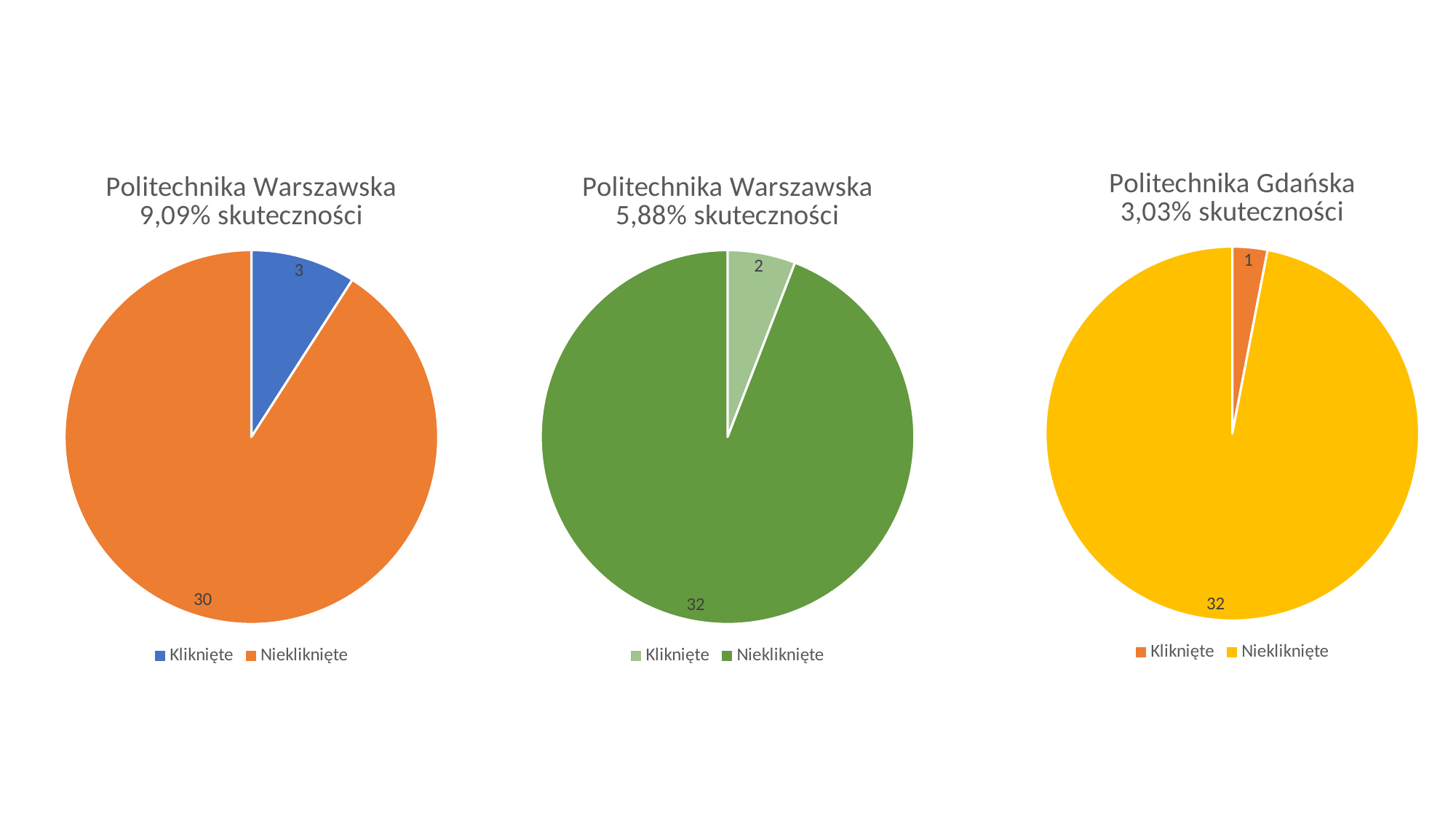
How many entries does the legend of the middle chart (Politechnika Warszawska 5,88% skuteczności) list? 2 In the right chart (Politechnika Gdańska 3,03% skuteczności), what is the value for Kliknięte? 1 In the middle chart (Politechnika Warszawska 5,88% skuteczności), what is the value for Niekliknięte? 32 What type of chart is the right chart (Politechnika Gdańska 3,03% skuteczności)? pie chart In the left chart (Politechnika Warszawska 9,09% skuteczności), what is the value for Kliknięte? 3 In the right chart (Politechnika Gdańska 3,03% skuteczności), what is the value for Niekliknięte? 32 In the left chart (Politechnika Warszawska 9,09% skuteczności), what share of the pie does Kliknięte represent? 9,09% In the left chart (Politechnika Warszawska 9,09% skuteczności), what is the difference between Niekliknięte and Kliknięte? 27 In the left chart (Politechnika Warszawska 9,09% skuteczności), what is the value for Niekliknięte? 30 In the middle chart (Politechnika Warszawska 5,88% skuteczności), which category is the largest? Niekliknięte In the middle chart (Politechnika Warszawska 5,88% skuteczności), what is the value for Kliknięte? 2 In the right chart (Politechnika Gdańska 3,03% skuteczności), what is the total of all slices? 33